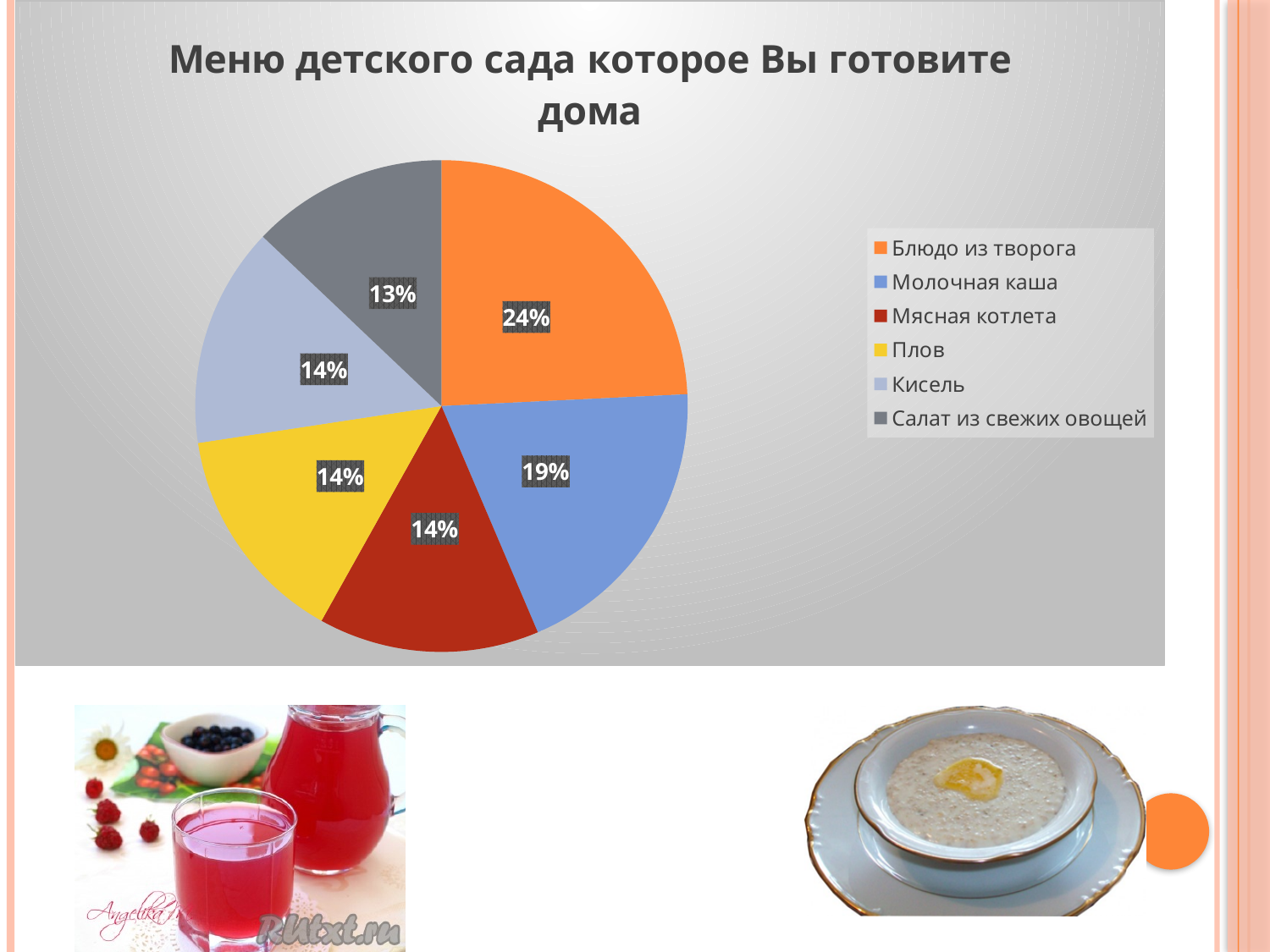
What percentage is shown for Плов? 14% Which has a larger share, Молочная каша or Кисель? Молочная каша How many categories does the pie chart show? 6 What percentage of the pie chart is labelled for Блюдо из творога? 24% What share does Молочная каша have in the pie chart? 19% What is the difference in percentage points between Блюдо из творога and Молочная каша? 5 What colour is the slice for Плов? yellow Which category has the largest slice of the pie chart? Блюдо из творога What is the title of the chart? Меню детского сада которое Вы готовите дома Which category has the smallest slice of the pie chart? Салат из свежих овощей What percentage is shown for Салат из свежих овощей? 13% What type of chart is shown on the slide? pie chart